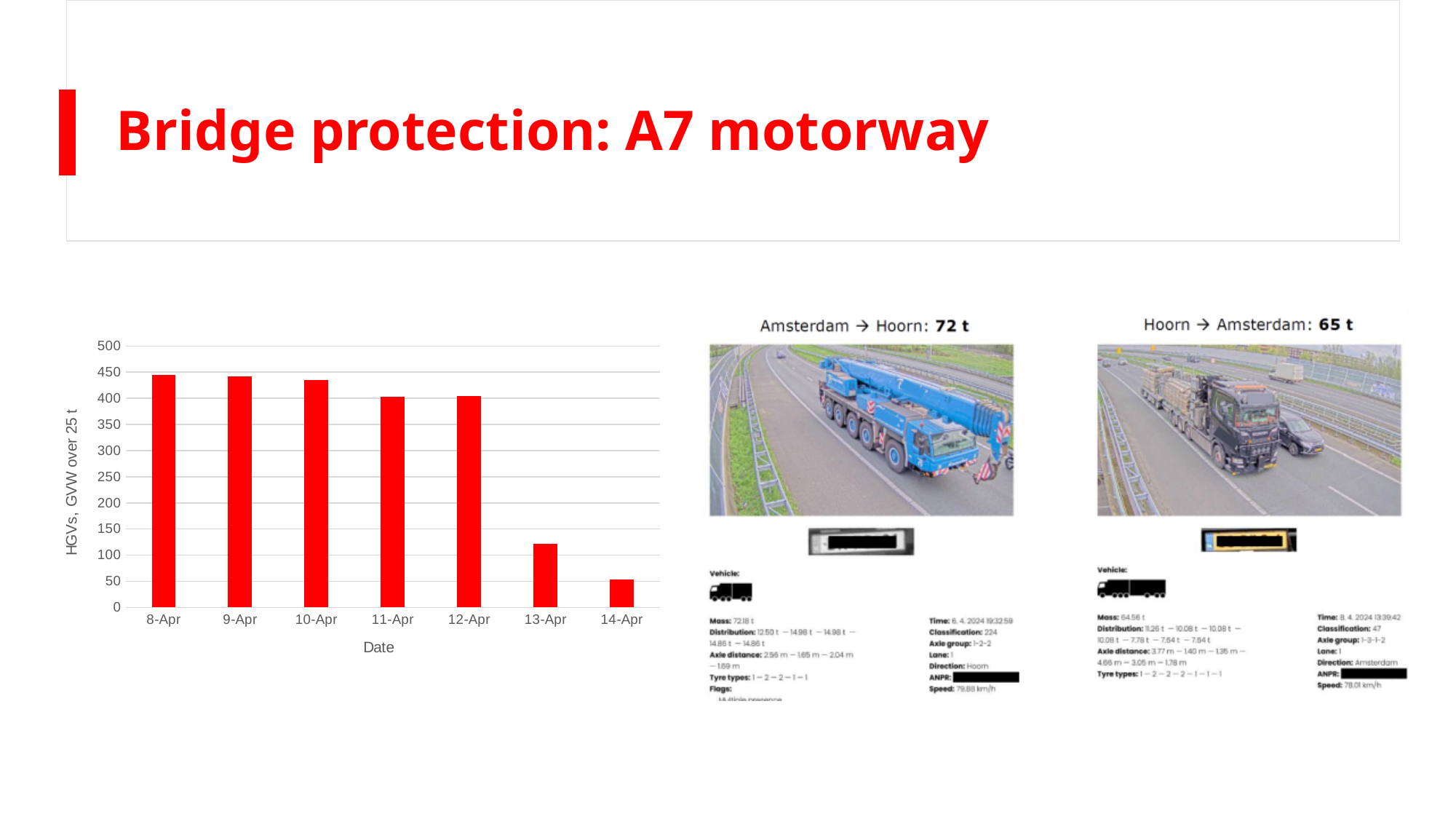
What is the label on the y axis of the bar chart? HGVs, GVW over 25 t Do the values in the bar chart generally rise or fall from 8-Apr to 14-Apr? fall How many dates are shown on the x axis of the bar chart? 7 Is the value for 13-Apr greater or less than 150? less Is the value for 10-Apr greater or less than 400? greater Which date has the lowest number of HGVs in the bar chart? 14-Apr What kind of chart is shown on the slide? bar chart Is the value for 11-Apr greater or less than 450? less Which is larger, the value for 9-Apr or the value for 13-Apr? 9-Apr